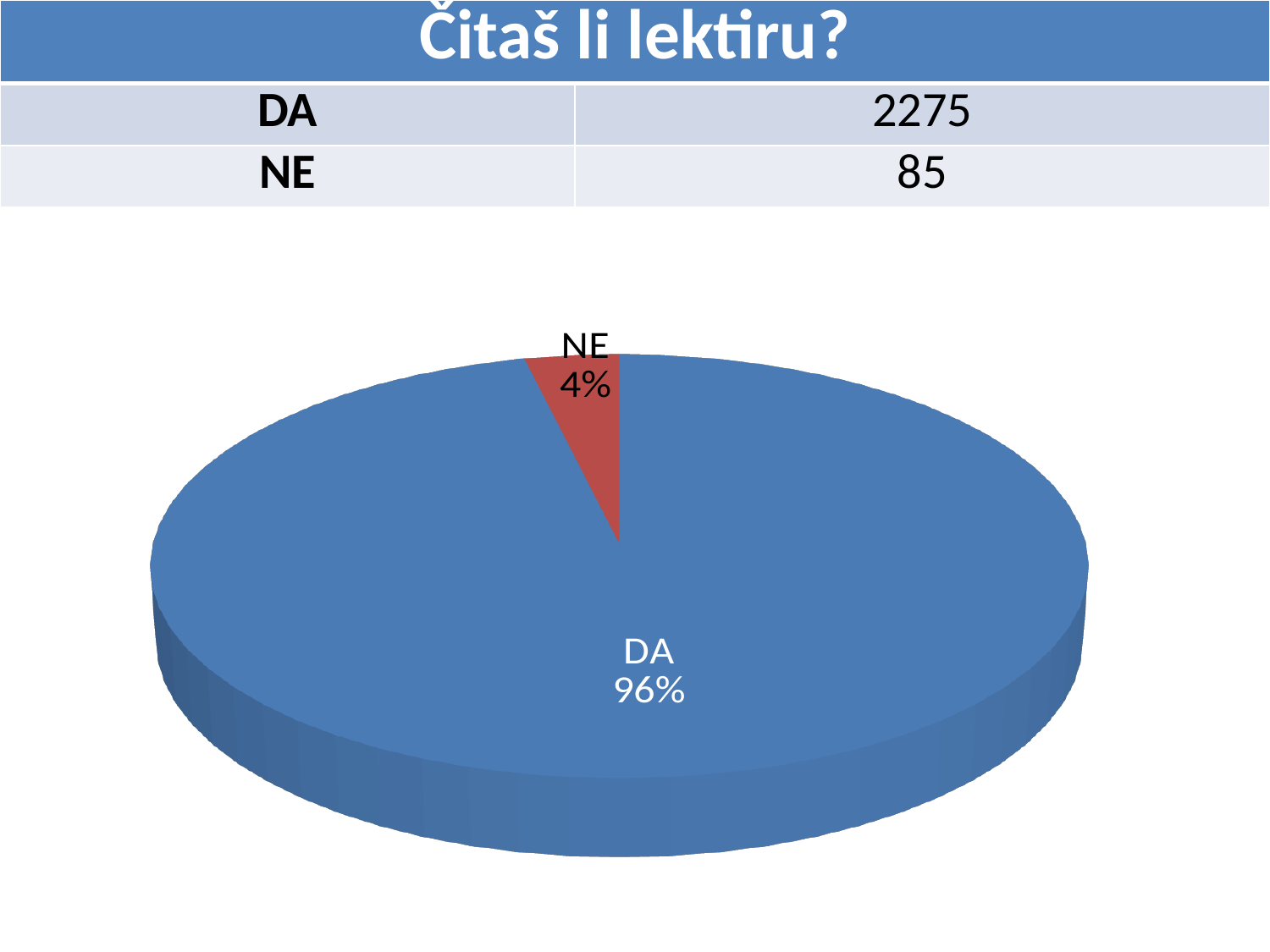
Which slice of the pie is the largest? DA How many slices does the pie chart have? 2 Which slice of the pie is the smallest? NE What is the difference in percentage points between the DA and NE slices? 92 What colour is the NE slice of the pie? red What is the title shown above the table on the slide? Čitaš li lektiru? What share of the pie does the NE slice represent? 4% What share of the pie does the DA slice represent? 96% Which is larger, the DA slice or the NE slice? DA What kind of chart is shown on the slide? pie chart